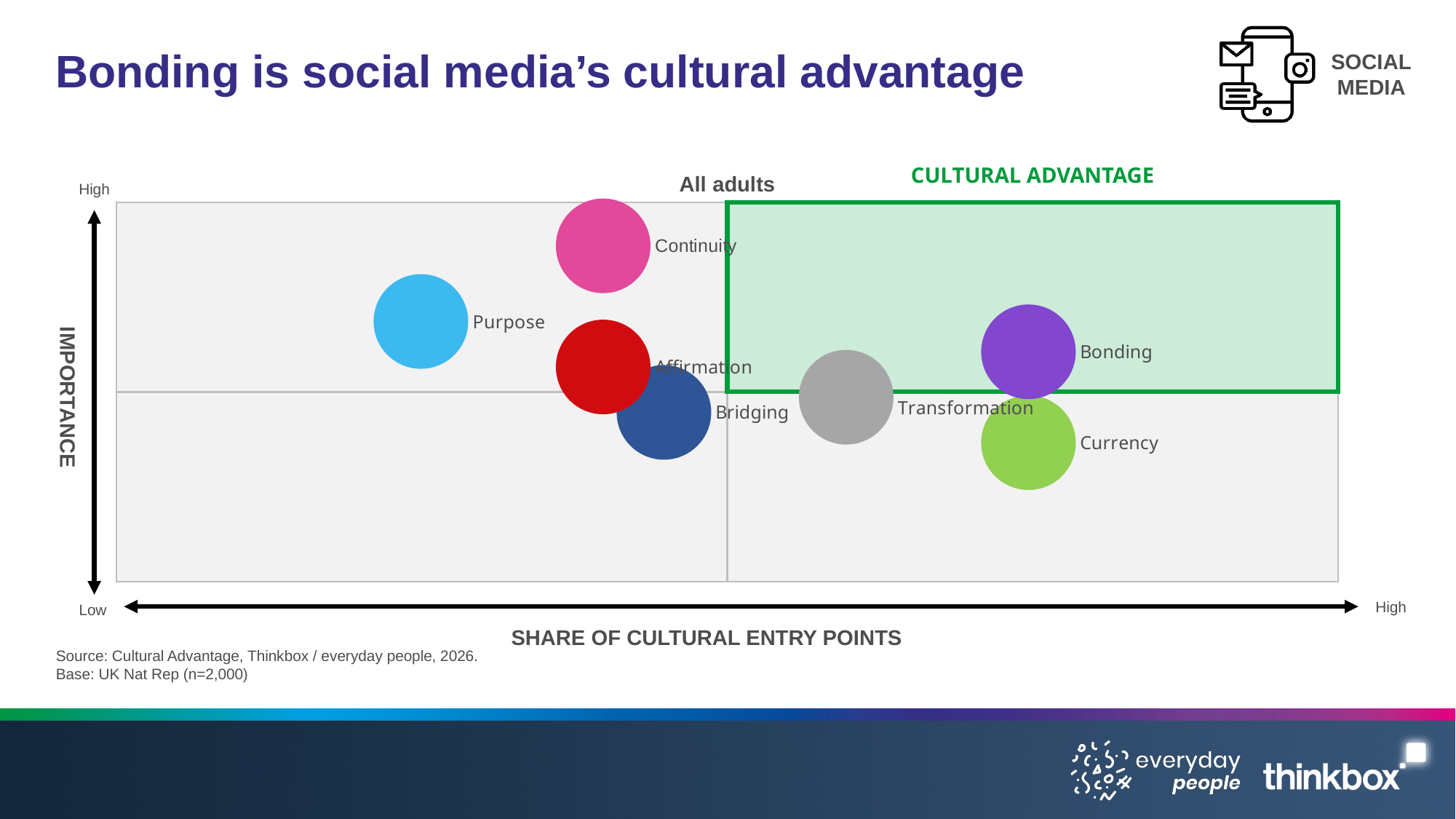
Which has a higher importance, Continuity or Purpose? Continuity What is the label of the horizontal axis? Share of cultural entry points Which category has the lowest importance on the chart? Currency How many bubbles (categories) are plotted on the chart? 7 Which has a higher importance, Affirmation or Bridging? Affirmation Which category has the highest importance on the chart? Continuity Which category falls inside the green 'Cultural Advantage' box? Bonding Which has a higher share of cultural entry points, Purpose or Bonding? Bonding Which category has the lowest share of cultural entry points? Purpose What kind of chart is shown on the slide? Bubble chart